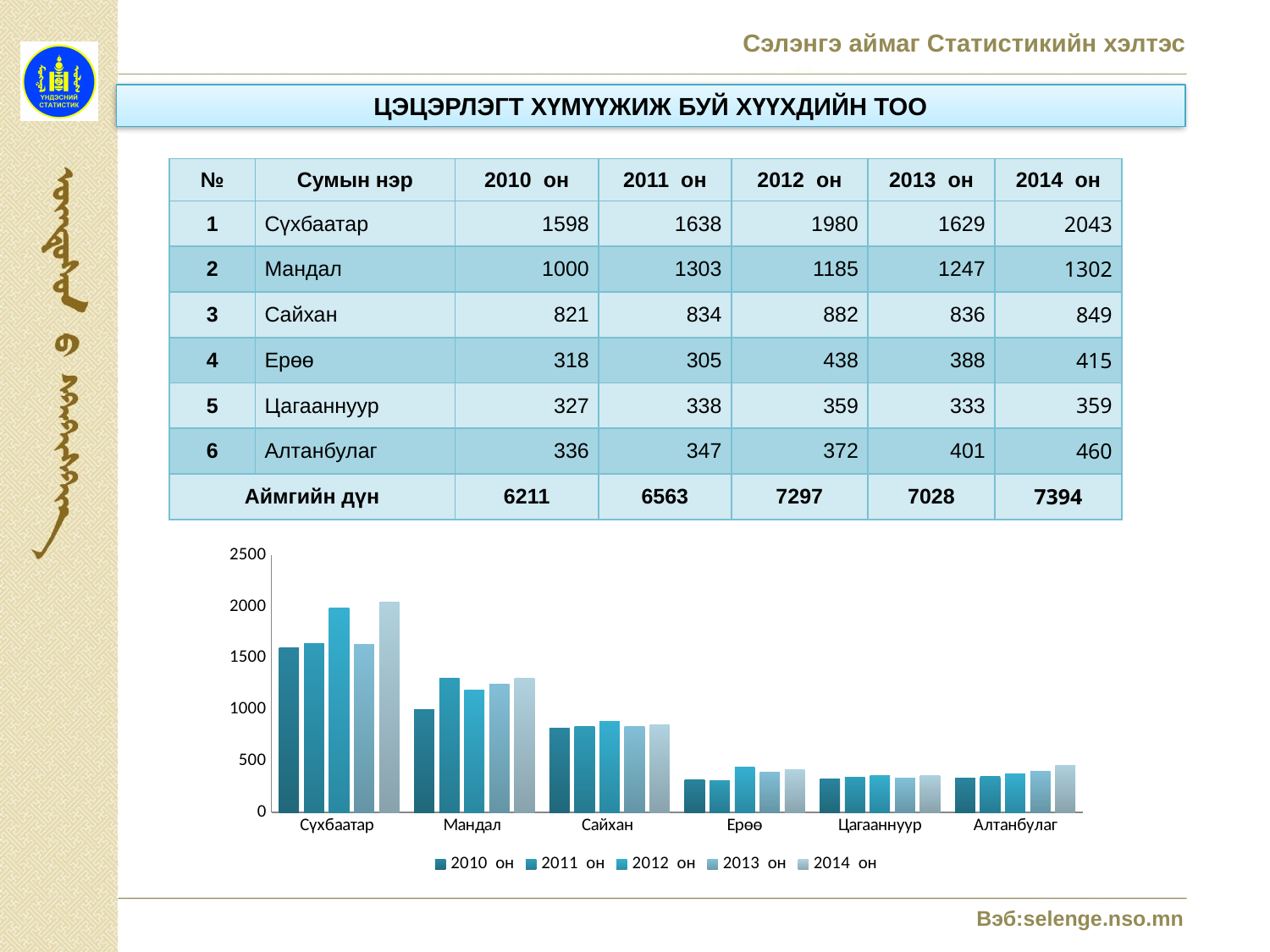
What is the value for Сүхбаатар in 2014? 2043 What kind of chart is shown on the slide? bar chart What is the value for Мандал in 2011? 1303 Which soum has the highest number of children in kindergarten in 2014? Сүхбаатар Do the values for Алтанбулаг rise or fall from 2010 to 2014? rise Which soum has the lowest number of children in kindergarten in 2010? Ерөө What is the difference between the 2014 and 2010 values for Алтанбулаг? 124 How many categories (soums) are shown on the x axis of the chart? 6 Which is larger: the 2012 value for Ерөө or the 2012 value for Цагааннуур? Ерөө What is the last series listed in the chart legend? 2014 он How many series does the chart legend list? 5 Is the 2012 value for Сүхбаатар greater or less than 1500? greater